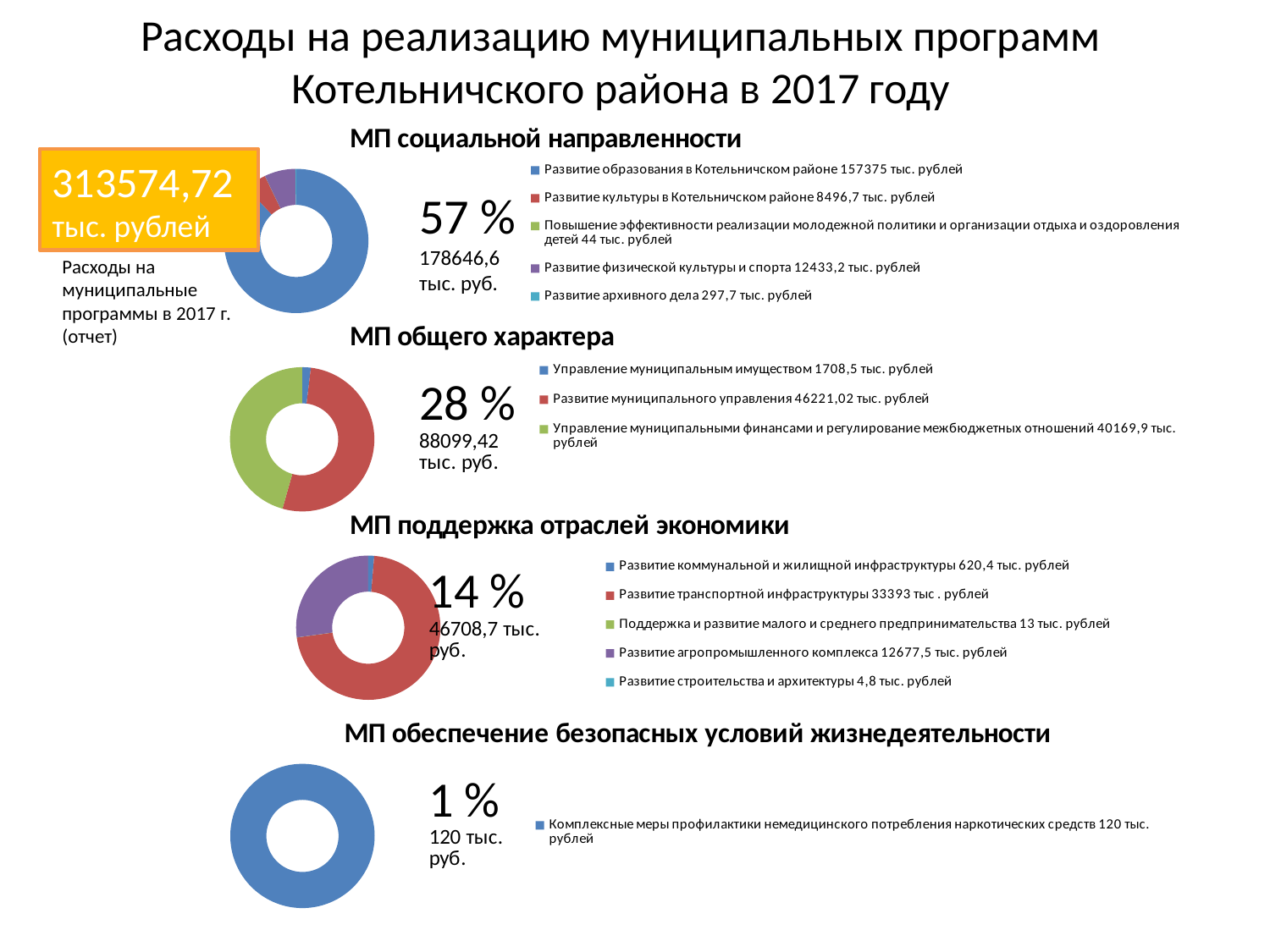
In the "МП социальной направленности" chart, which category has the smallest value? Повышение эффективности реализации молодежной политики и организации отдыха и оздоровления детей In the "МП поддержка отраслей экономики" chart, what is the difference between "Развитие транспортной инфраструктуры" and "Развитие агропромышленного комплекса"? 20715,5 тыс. рублей How many entries does the legend of the "МП социальной направленности" chart list? 5 How many categories does the "МП поддержка отраслей экономики" chart have? 5 In the "МП общего характера" chart, what is the value for "Развитие муниципального управления"? 46221,02 тыс. рублей In the "МП поддержка отраслей экономики" chart, what is the value for "Развитие агропромышленного комплекса"? 12677,5 тыс. рублей What kind of chart is used for "МП социальной направленности"? doughnut chart In the "МП общего характера" chart, which category has the largest value? Развитие муниципального управления In the "МП общего характера" chart, which is larger: "Управление муниципальным имуществом" or "Управление муниципальными финансами и регулирование межбюджетных отношений"? Управление муниципальными финансами и регулирование межбюджетных отношений What share of total expenditure does the "МП общего характера" chart represent, as printed on the slide? 28 % In the "МП социальной направленности" chart, what is the value for "Развитие образования в Котельничском районе"? 157375 тыс. рублей What total amount is printed next to the "МП обеспечение безопасных условий жизнедеятельности" chart? 120 тыс. руб.